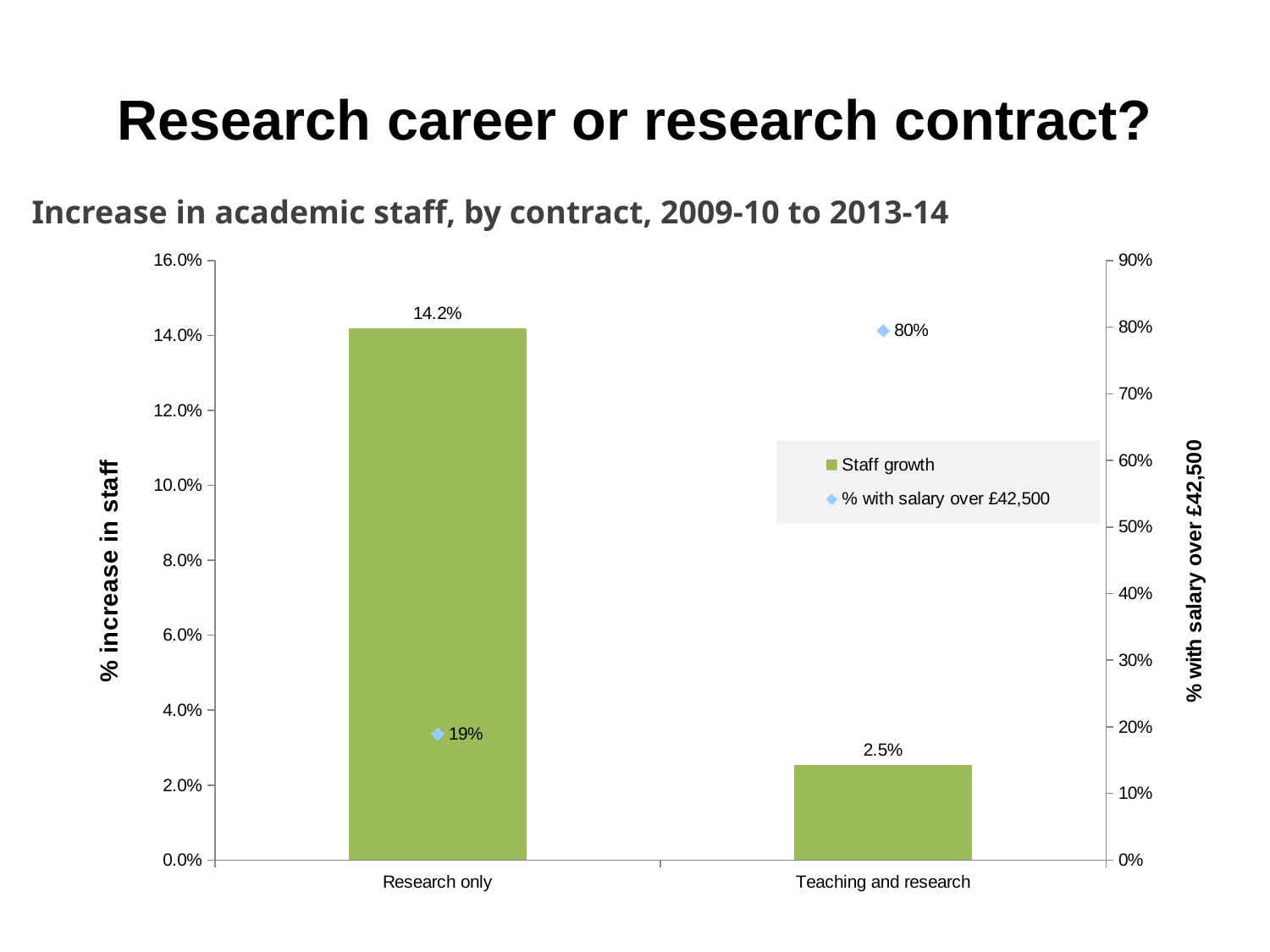
Is the staff growth for Research only greater or less than 10.0%? greater How many series does the legend list? 2 What percentage of Research only staff have a salary over £42,500? 19% What percentage of Teaching and research staff have a salary over £42,500? 80% How many contract categories are shown on the x axis? 2 Which contract type has the lower percentage of staff with salary over £42,500? Research only What is the title of the chart? Increase in academic staff, by contract, 2009-10 to 2013-14 What is the staff growth value for Research only? 14.2% What is the difference in staff growth between Research only and Teaching and research? 11.7% What is the staff growth value for Teaching and research? 2.5% Which contract type has the higher staff growth? Research only What is the difference in the percentage with salary over £42,500 between Teaching and research and Research only? 61%